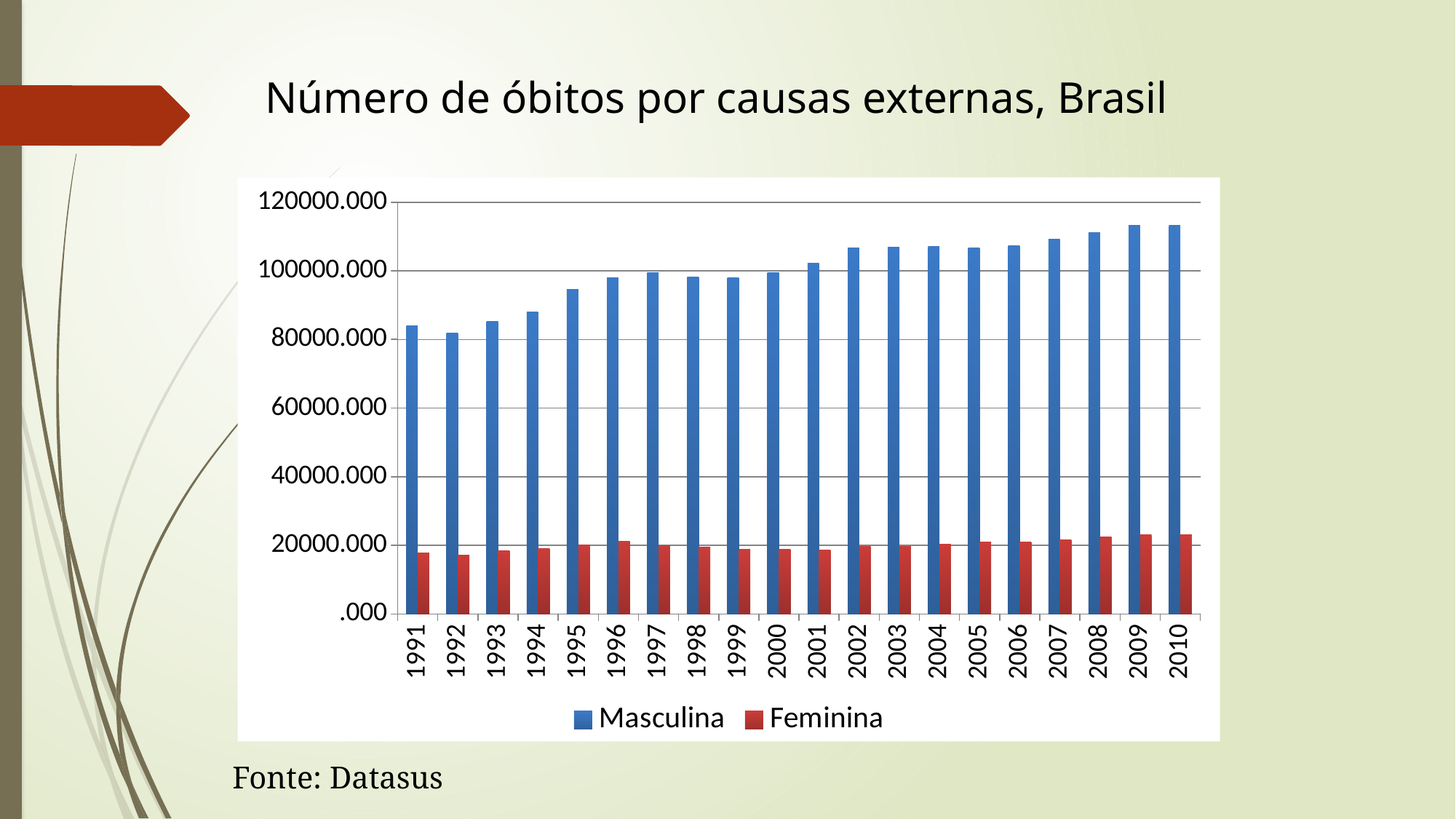
Which is larger, the Masculina value for 2010 or the Masculina value for 1991? 2010 How many series does the legend list? 2 What is the title of the chart? Número de óbitos por causas externas, Brasil Is the Masculina value for 2010 greater or less than 100000.000? greater Is the Feminina value for 1991 greater or less than 20000.000? less How many years are shown on the x axis? 20 Is the Masculina value for 1995 greater or less than 100000.000? less Do the Masculina values generally rise or fall from 1991 to 2010? rise What kind of chart is shown on the slide? bar chart Which series has the higher values in every year, Masculina or Feminina? Masculina